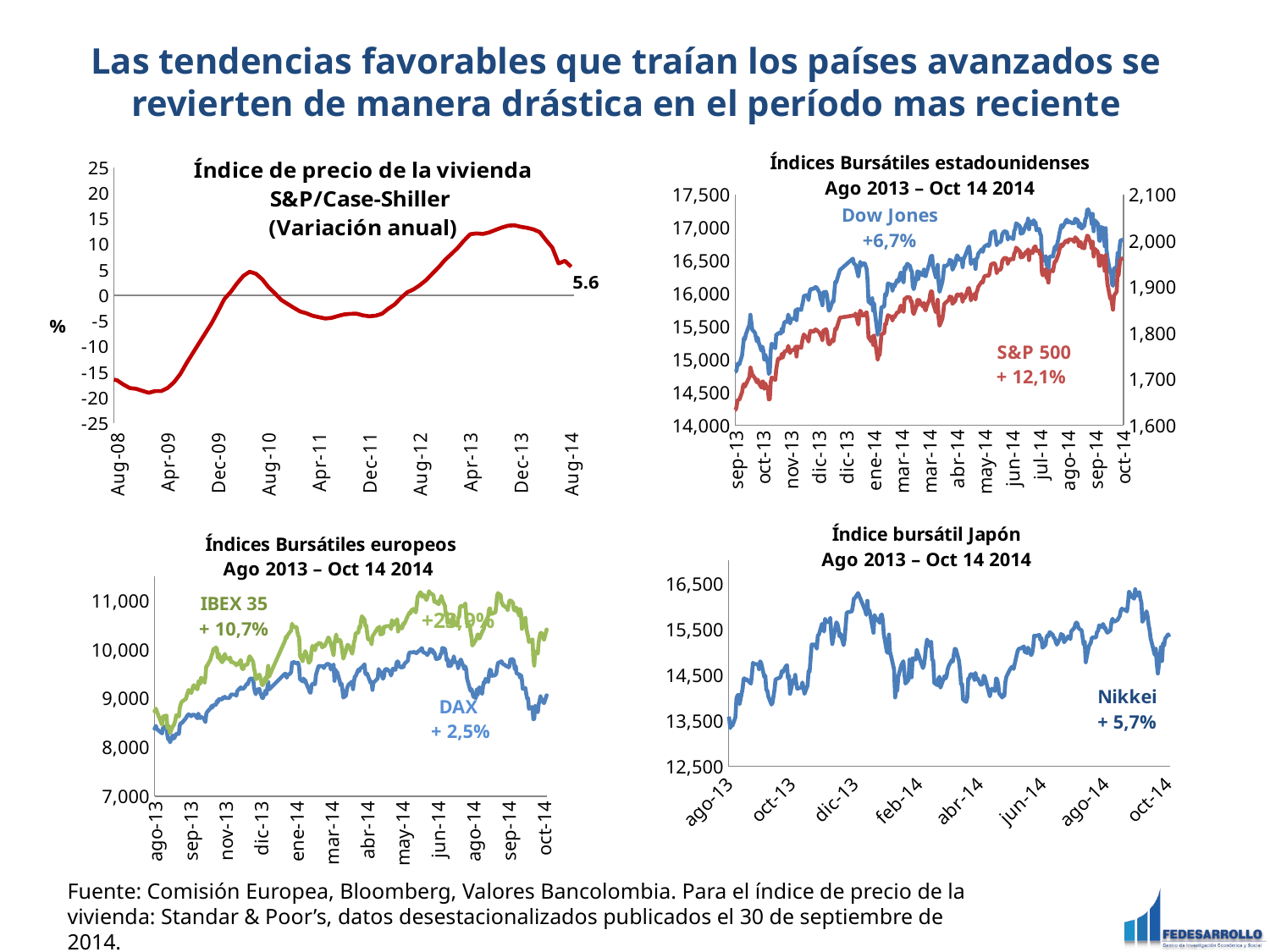
On the 'Índice de precio de la vivienda S&P/Case-Shiller' chart, does the line rise or fall between Aug-08 and Dec-09? rises On the 'Índices Bursátiles europeos' chart, what percentage change is shown for the IBEX 35? + 10,7% On the 'Índices Bursátiles estadounidenses' chart, what percentage change is shown for the Dow Jones? +6,7% On the 'Índices Bursátiles estadounidenses' chart, which index shows the larger percentage gain, Dow Jones or S&P 500? S&P 500 On the 'Índice de precio de la vivienda S&P/Case-Shiller' chart, what is the value printed at the end of the line (Aug-14)? 5.6 On the 'Índice bursátil Japón' chart, what percentage change is shown for the Nikkei? + 5,7% On the 'Índice de precio de la vivienda S&P/Case-Shiller' chart, is the value at Dec-13 greater or less than 10? greater On the 'Índice de precio de la vivienda S&P/Case-Shiller' chart, is the value at Aug-08 greater or less than -10? less On the 'Índices Bursátiles estadounidenses' chart, what percentage change is shown for the S&P 500? + 12,1% On the 'Índice de precio de la vivienda S&P/Case-Shiller' chart, what kind of chart is shown? line chart On the 'Índices Bursátiles europeos' chart, what percentage change is shown for the DAX? + 2,5% On the 'Índices Bursátiles estadounidenses' chart, how many series are plotted? 2